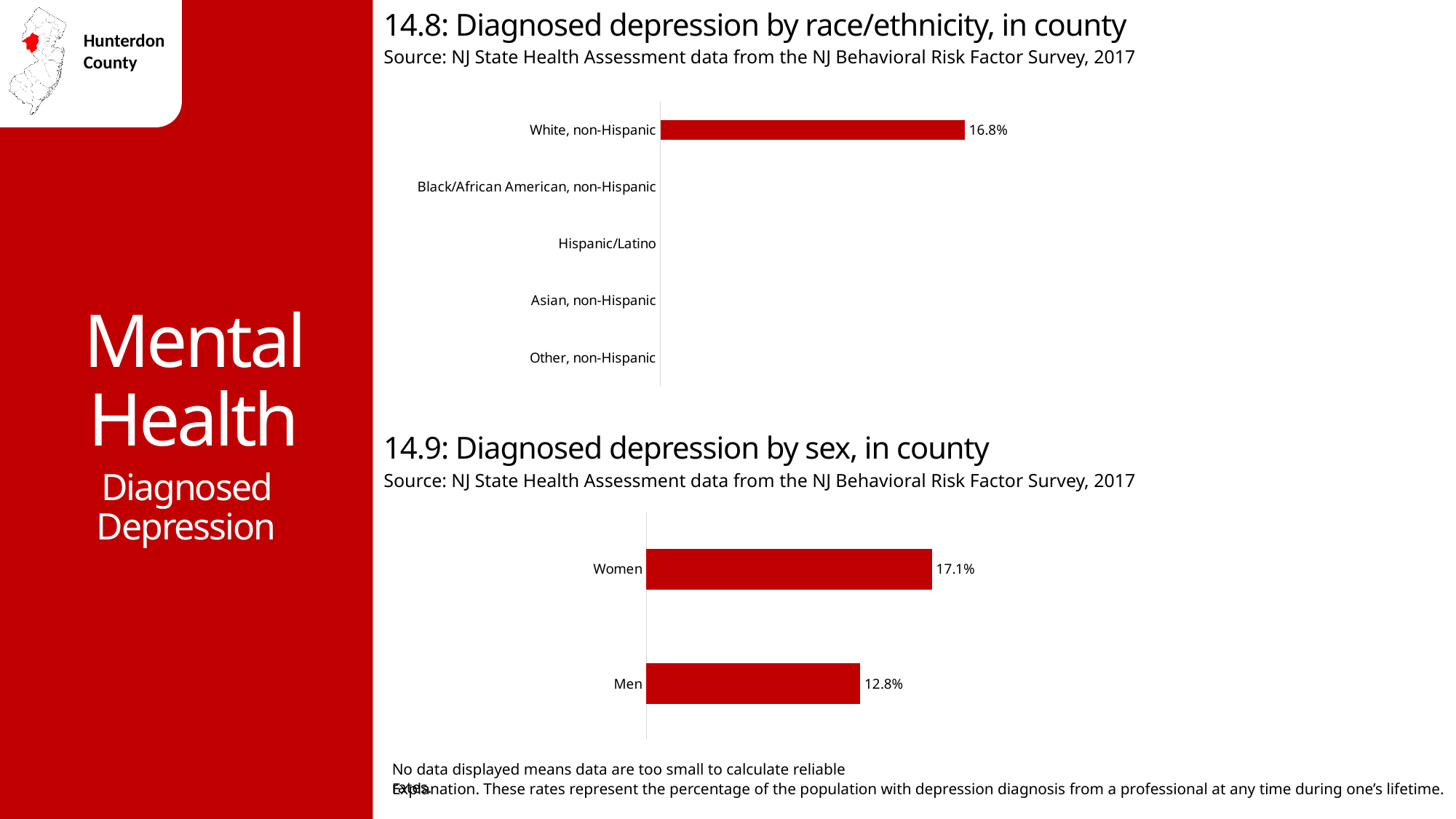
What kind of chart is '14.9: Diagnosed depression by sex, in county'? Bar chart In the chart '14.8: Diagnosed depression by race/ethnicity, in county', what is the value for White, non-Hispanic? 16.8% In the chart '14.8: Diagnosed depression by race/ethnicity, in county', how many race/ethnicity categories are listed on the axis? 5 What kind of chart is '14.8: Diagnosed depression by race/ethnicity, in county'? Bar chart In the chart '14.8: Diagnosed depression by race/ethnicity, in county', which category is the only one with a bar displayed? White, non-Hispanic In the chart '14.9: Diagnosed depression by sex, in county', what is the value for Men? 12.8% In the chart '14.9: Diagnosed depression by sex, in county', how many categories are shown? 2 In the chart '14.9: Diagnosed depression by sex, in county', what is the difference between the values for Women and Men? 4.3% In the chart '14.9: Diagnosed depression by sex, in county', is the value for Women larger or smaller than the value for Men? Larger In the chart '14.9: Diagnosed depression by sex, in county', what is the value for Women? 17.1% In the chart '14.9: Diagnosed depression by sex, in county', which category has the higher value? Women In the chart '14.9: Diagnosed depression by sex, in county', which category has the lower value? Men